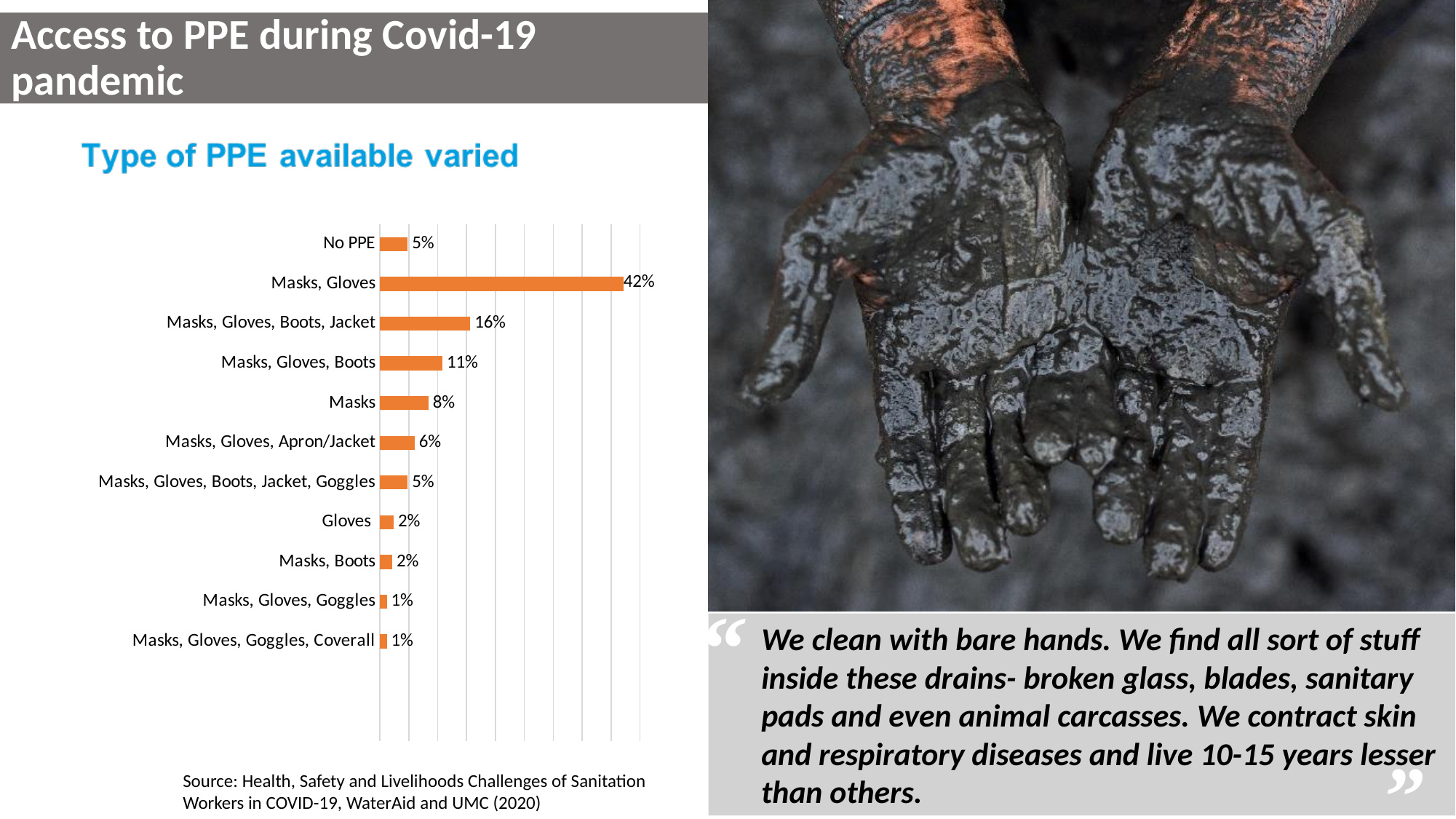
What is the value for No PPE? 5% What colour are the bars in the chart? Orange What is the value for Masks, Gloves, Boots? 11% What kind of chart is shown on the slide? Bar chart What is the difference between the values for Masks, Gloves and Masks, Gloves, Boots, Jacket? 26% What is the title of the chart? Type of PPE available varied Which is larger, the value for Masks or the value for Masks, Gloves, Apron/Jacket? Masks How many PPE categories are shown in the chart? 11 Which PPE category has the highest value? Masks, Gloves What is the difference between the values for Masks, Gloves, Boots and Masks? 3% What is the value for Masks, Gloves, Boots, Jacket? 16% What percentage of workers had Masks, Gloves as their available PPE? 42%